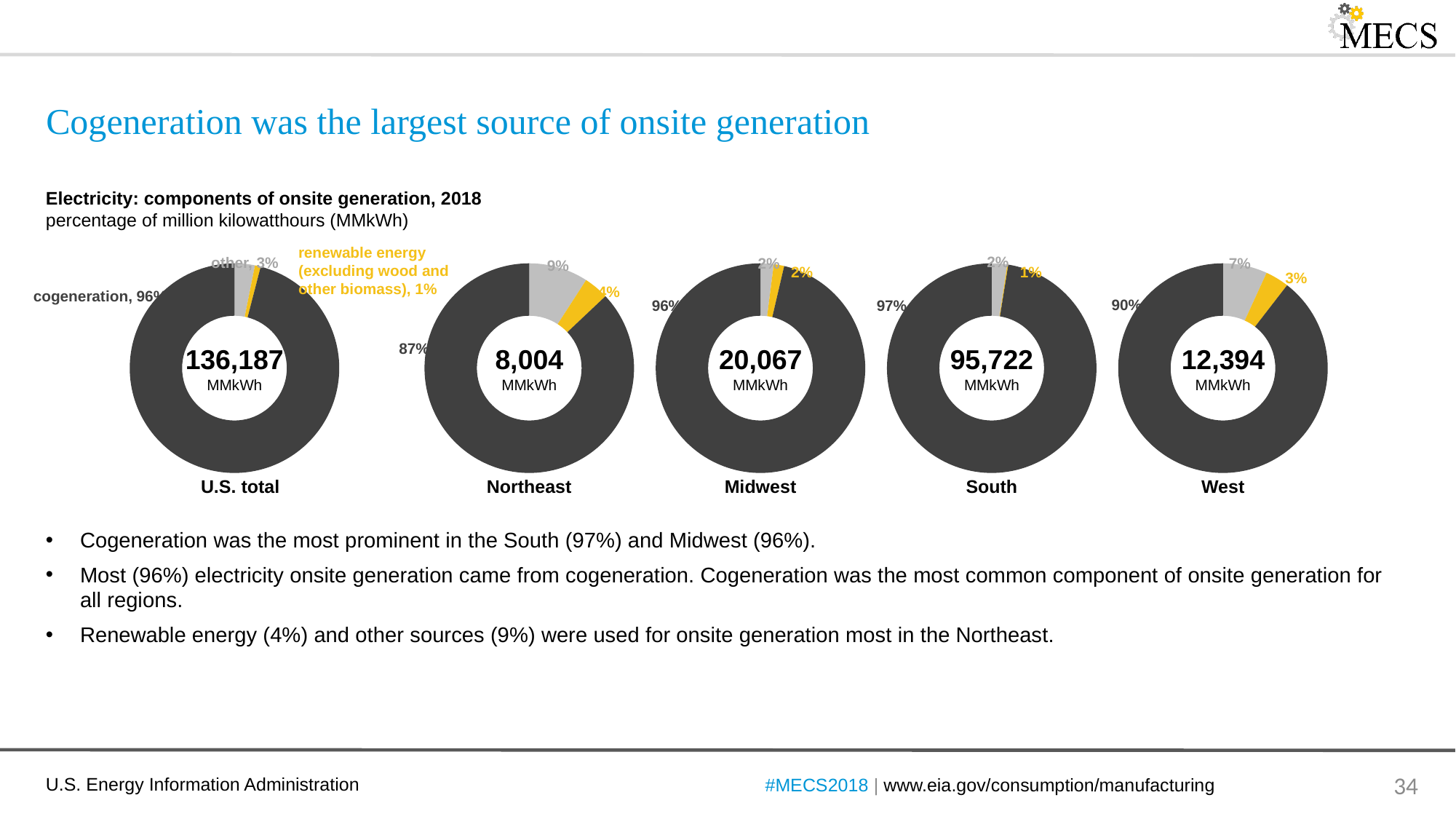
In the Northeast donut chart, what percentage is shown for the 'other' component? 9% What total onsite generation in MMkWh is shown in the center of the South donut chart? 95,722 What type of chart is used to show the components of onsite generation for each region? Donut (pie) chart Which region has the smallest total onsite generation shown in the center of its donut chart? Northeast What total onsite generation in MMkWh is shown in the center of the West donut chart? 12,394 What is the difference between the cogeneration percentage in the South and in the Northeast? 10 percentage points How many donut charts are shown on the slide? 5 Is the total onsite generation shown for the Midwest larger or smaller than that shown for the West? Larger In the U.S. total donut chart, what share of onsite generation came from cogeneration? 96% Which region's donut chart shows the lowest cogeneration percentage? Northeast In the Northeast donut chart, what share of onsite generation came from renewable energy (excluding wood and other biomass)? 4% Which region's donut chart shows the highest cogeneration percentage? South